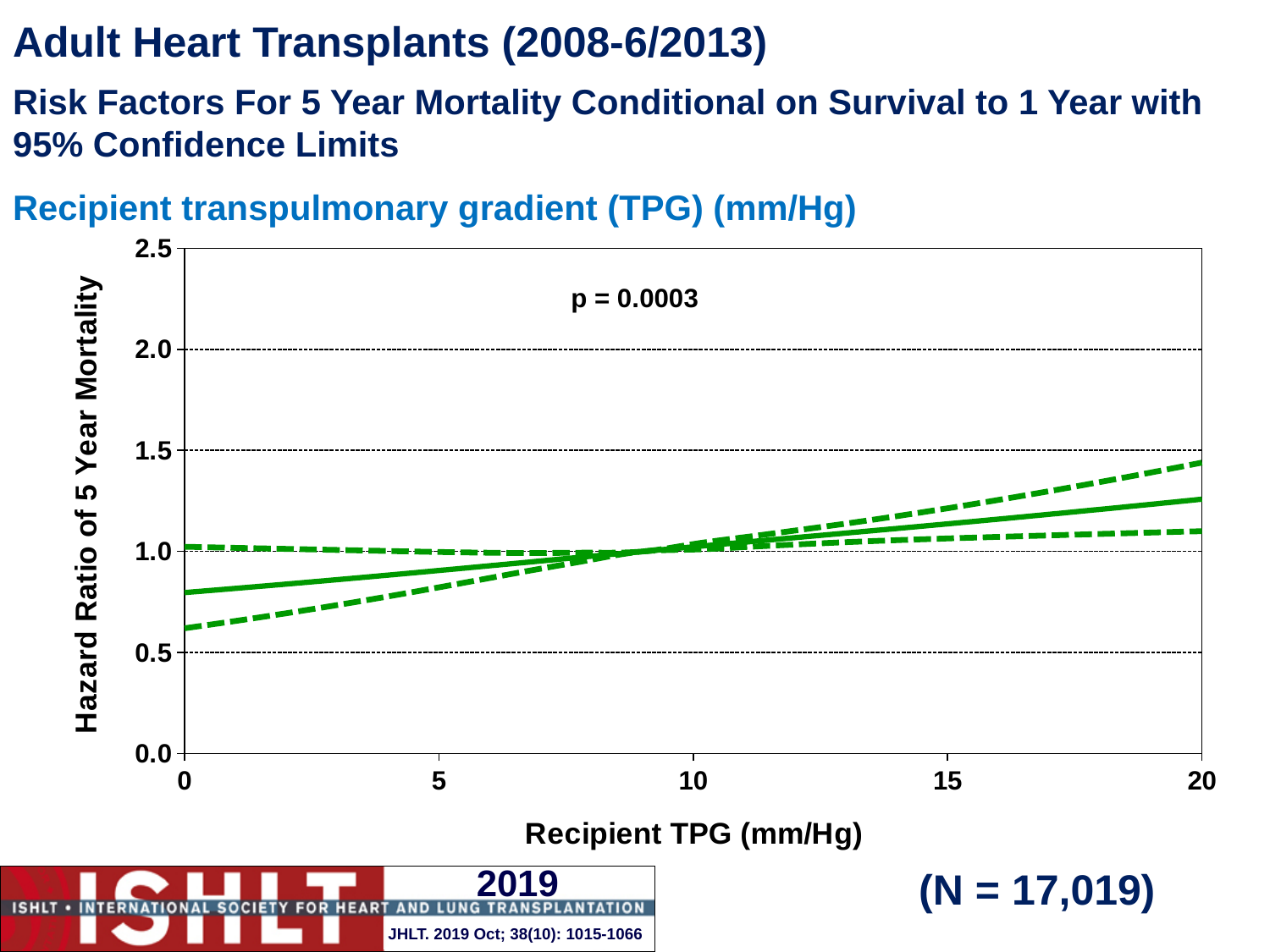
What p-value is printed on the chart? p = 0.0003 Is the hazard ratio on the solid line at a Recipient TPG of 20 mm/Hg greater or less than 1.0? greater Does the solid hazard ratio line rise or fall as Recipient TPG increases from 0 to 20 mm/Hg? rise How many lines are plotted on the chart? 3 Which is larger at a Recipient TPG of 20 mm/Hg: the solid hazard ratio line or the lower dashed confidence limit? the solid hazard ratio line Is the upper dashed confidence limit at a Recipient TPG of 20 mm/Hg greater or less than 1.5? less Is the hazard ratio on the solid line at a Recipient TPG of 0 mm/Hg greater or less than 1.0? less What kind of chart is shown on the slide? line chart What sample size (N) is shown on the slide? N = 17,019